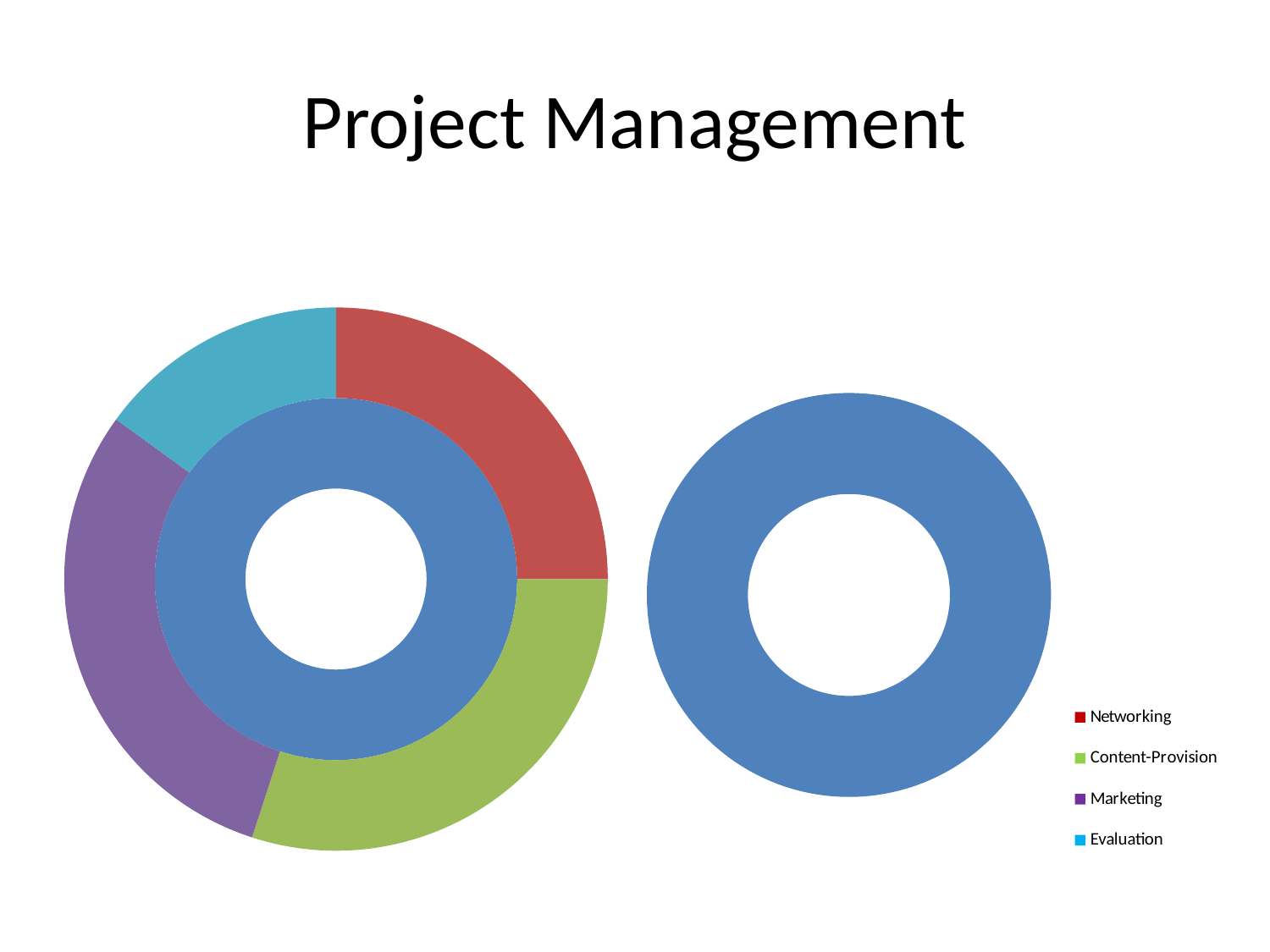
What is the title of the slide containing the charts? Project Management In the left doughnut chart, which category has the smallest segment in the outer ring? Evaluation What kind of chart is shown on the left of the slide? Doughnut chart What colour represents Networking in the legend? Red In the left doughnut chart, which outer-ring segment is larger: Networking or Evaluation? Networking How many entries does the legend list? 4 How many categories are shown in the outer ring of the left doughnut chart? 4 In the left doughnut chart, which outer-ring segment is larger: Content-Provision or Evaluation? Content-Provision In the left doughnut chart, which outer-ring segment is larger: Marketing or Evaluation? Marketing How many doughnut charts are shown on the slide? 2